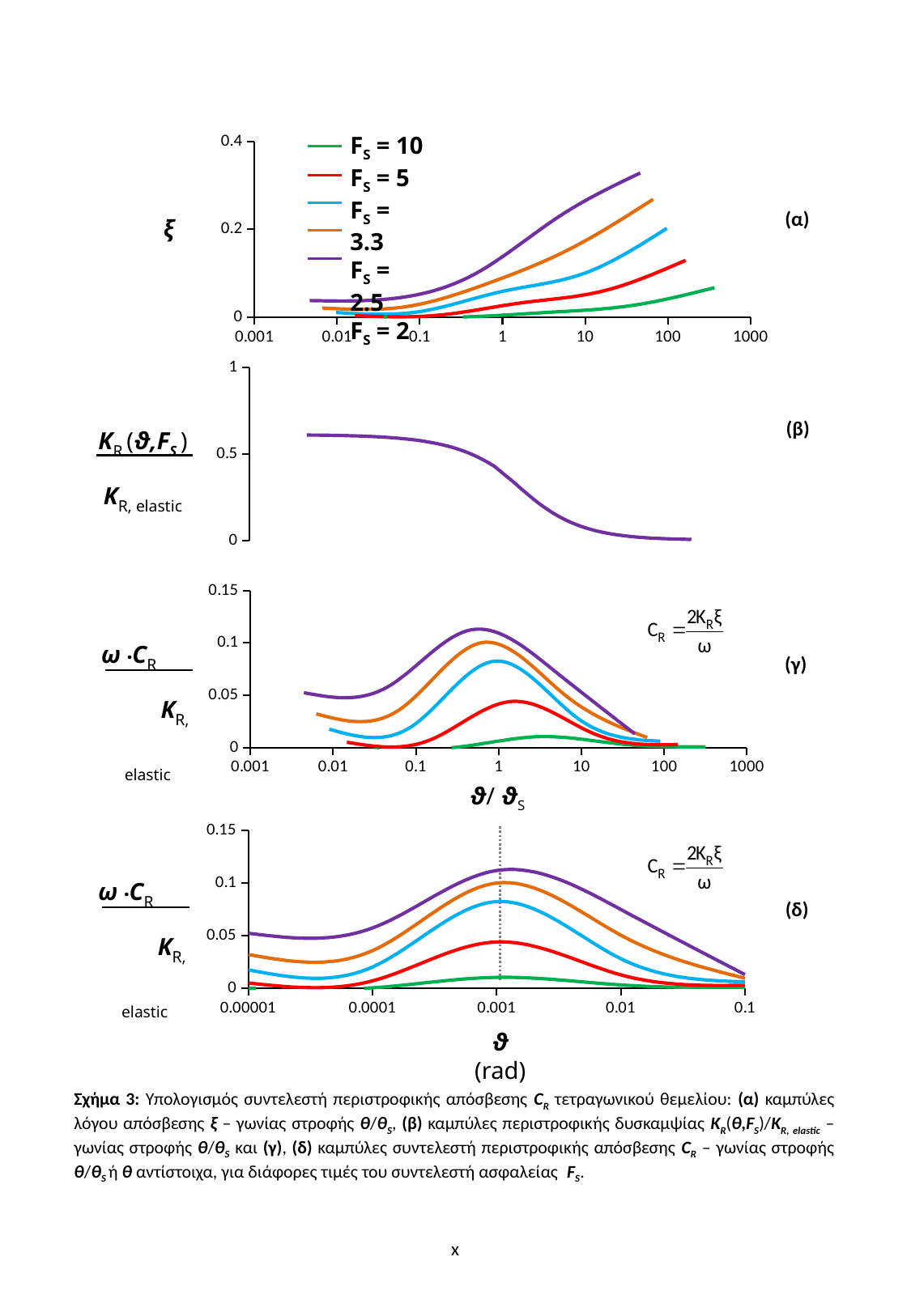
What kind of chart is chart (α)? line chart In chart (γ), is the peak value of the F_s = 2 (purple) curve greater or less than 0.1? greater In chart (α), is the maximum ξ value reached by the F_s = 2 curve greater or less than 0.2? greater In chart (γ), is the peak value of the F_s = 10 (green) curve greater or less than 0.05? less What is the x-axis label of chart (δ)? θ (rad) In chart (α), which F_s value corresponds to the curve with the lowest ξ values? F_s = 10 In chart (β), does the K_R(θ,F_s)/K_R,elastic curve rise or fall as θ/θ_s increases? fall How many series does the legend in chart (α) list? 5 What formula is printed inside charts (γ) and (δ)? C_R = 2K_Rξ/ω In chart (α), which F_s value corresponds to the curve with the highest ξ values? F_s = 2 In chart (α), do the ξ curves rise or fall as θ/θ_s increases? rise